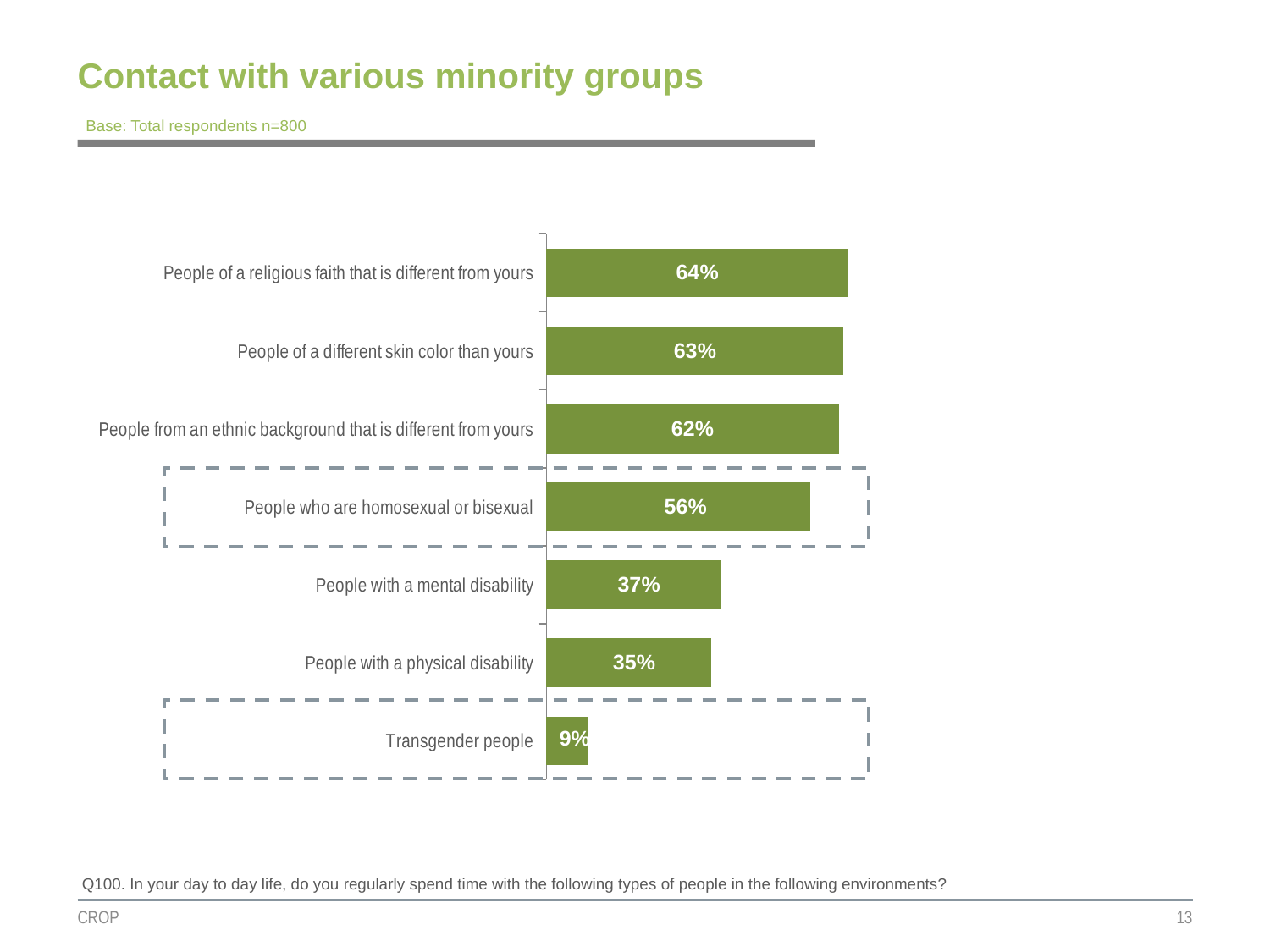
What is the value shown for 'People with a physical disability'? 35% What is the value shown for 'People who are homosexual or bisexual'? 56% What is the base (number of respondents) stated on the slide? n=800 What is the difference between the values for 'People with a mental disability' and 'People with a physical disability'? 2% What percentage of respondents regularly spend time with people of a religious faith that is different from theirs? 64% What is the difference between the values for 'People of a different skin color than yours' and 'Transgender people'? 54% Which category has the lowest value in the chart? Transgender people Which is larger: the value for 'People from an ethnic background that is different from yours' or the value for 'People who are homosexual or bisexual'? People from an ethnic background that is different from yours Which category has the highest value in the chart? People of a religious faith that is different from yours What kind of chart is shown on the slide? Bar chart How many categories are shown in the chart? 7 What is the value shown for 'Transgender people'? 9%